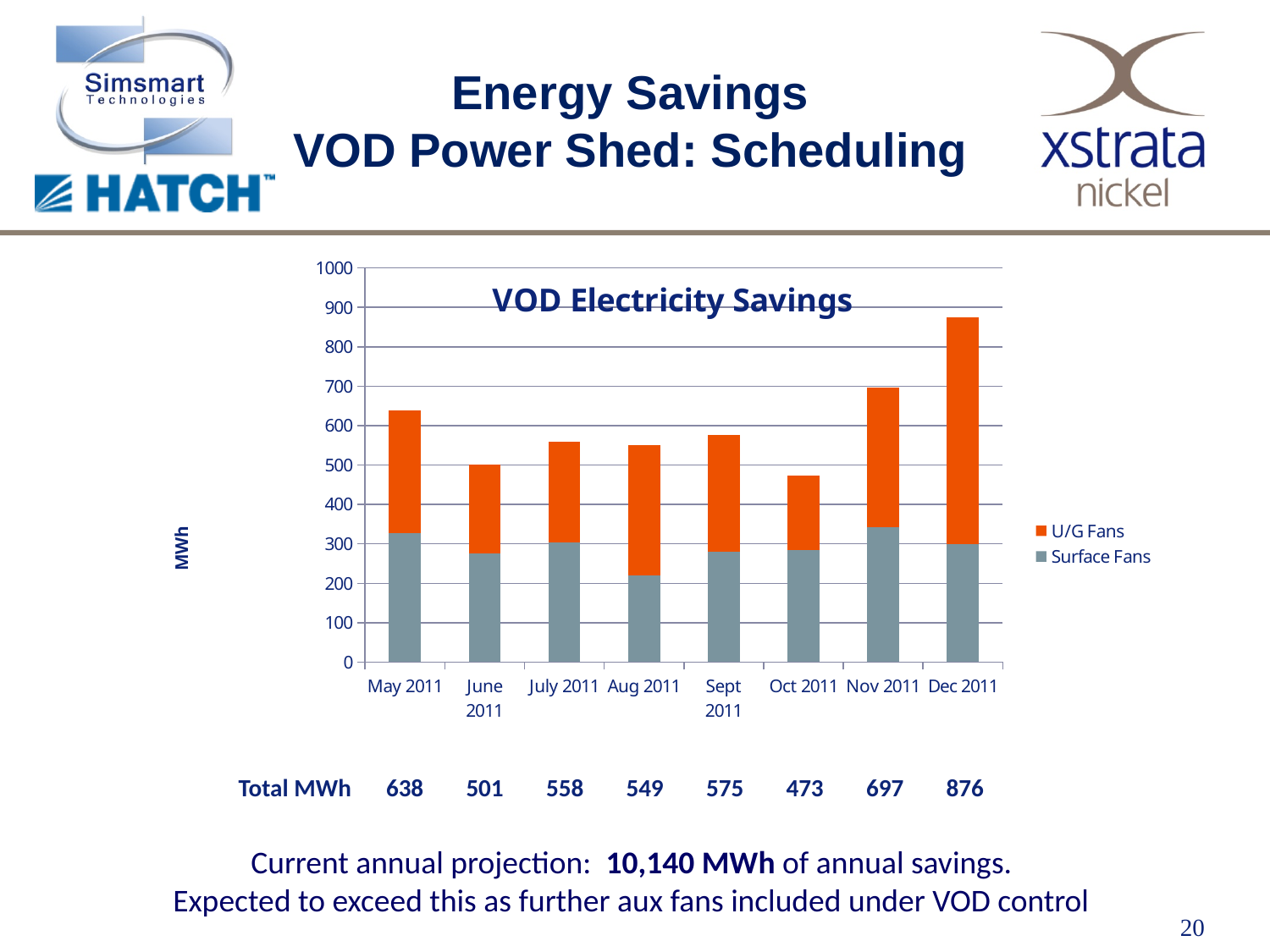
What is the title of the chart? VOD Electricity Savings How many series does the legend list? 2 Which month has the lowest total MWh? Oct 2011 How many months are plotted on the x axis? 8 What is the total MWh for Oct 2011? 473 Is the Surface Fans value for Aug 2011 greater or less than 300? less Which has a larger total MWh, May 2011 or Sept 2011? May 2011 What is the difference in total MWh between Dec 2011 and Nov 2011? 179 What type of chart is shown on the slide? stacked bar chart What is the total MWh for Dec 2011? 876 Which month has the highest total MWh? Dec 2011 Which series is shown in orange in the legend? U/G Fans